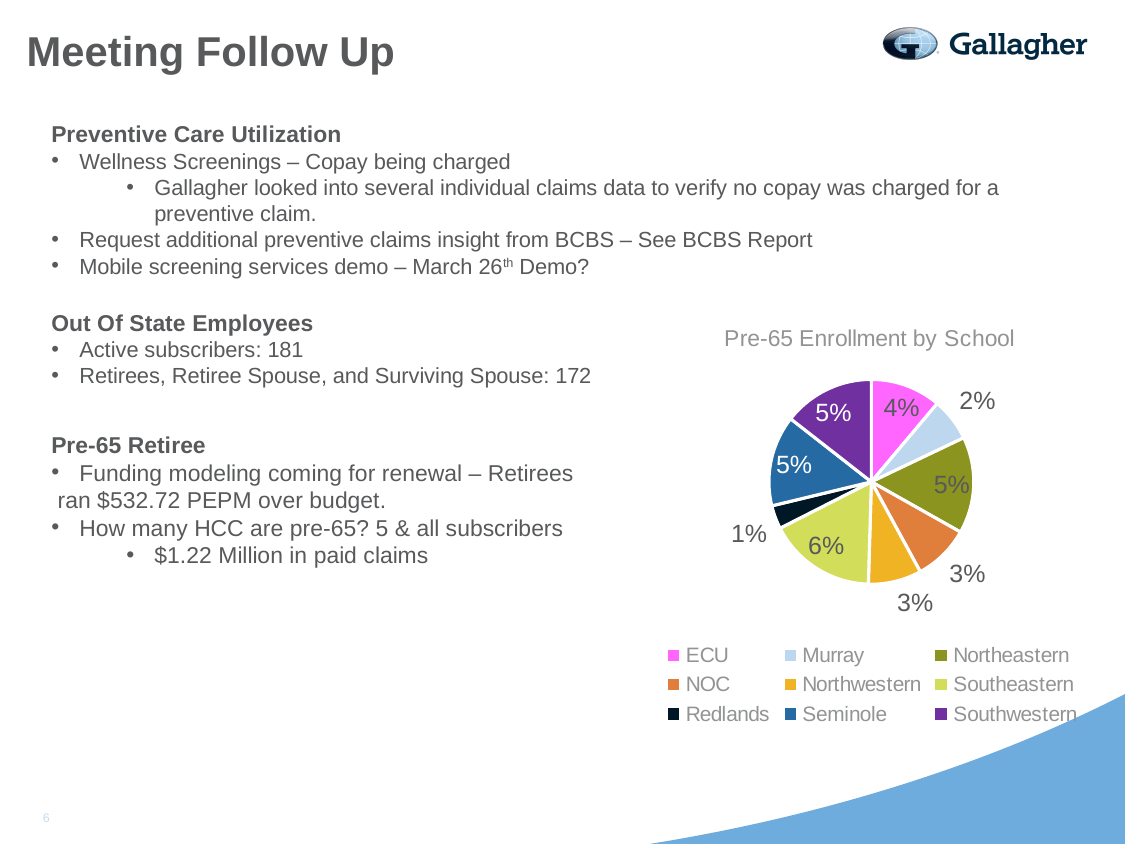
Which colour represents Southwestern in the pie chart? Purple What is the title of the chart? Pre-65 Enrollment by School How many schools are shown in the pie chart? 9 What is the value shown for Redlands in the pie chart? 1% Which is larger, the value for ECU or the value for NOC? ECU Which school has the largest slice in the pie chart? Southeastern What is the value shown for ECU in the pie chart? 4% What type of chart is shown on the slide? Pie chart What is the value shown for Murray in the pie chart? 2% What is the difference between the values for Southeastern and Murray? 4% Which school has the smallest slice in the pie chart? Redlands What is the value shown for Southeastern in the pie chart? 6%